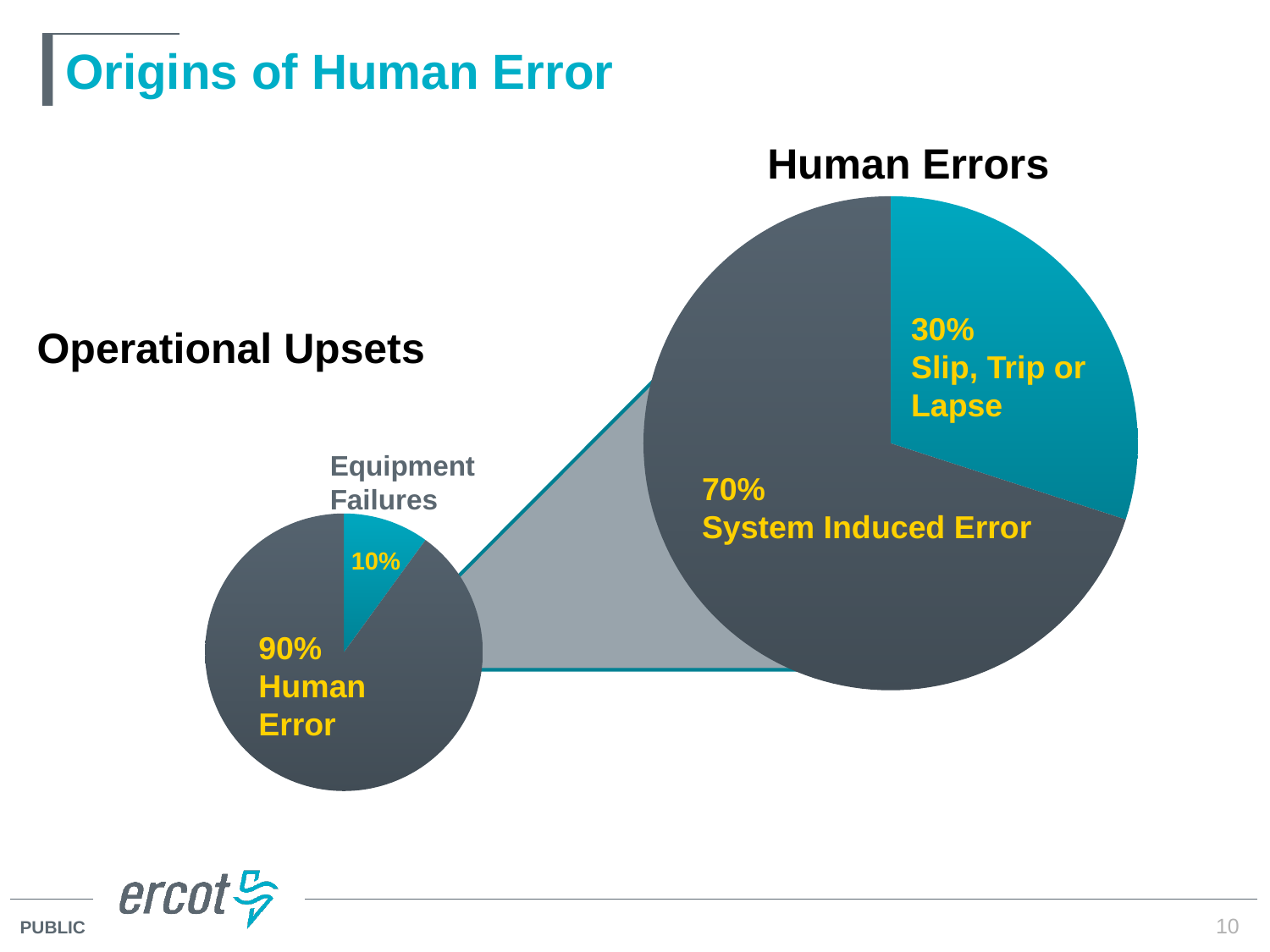
In the "Operational Upsets" chart, which slice is the largest? Human Error In the "Operational Upsets" chart, what is the difference between the Human Error share and the Equipment Failures share? 80% How many slices does the "Human Errors" chart have? 2 In the "Human Errors" chart, which is larger: System Induced Error or Slip, Trip or Lapse? System Induced Error What is the title of the slide? Origins of Human Error In the "Human Errors" chart, what share is Slip, Trip or Lapse? 30% In the "Human Errors" chart, what is the difference between the System Induced Error share and the Slip, Trip or Lapse share? 40% In the "Operational Upsets" chart, what share is Human Error? 90% In the "Operational Upsets" chart, what share is Equipment Failures? 10% What kind of chart is the "Operational Upsets" chart? pie chart In the "Human Errors" chart, which slice is the smallest? Slip, Trip or Lapse